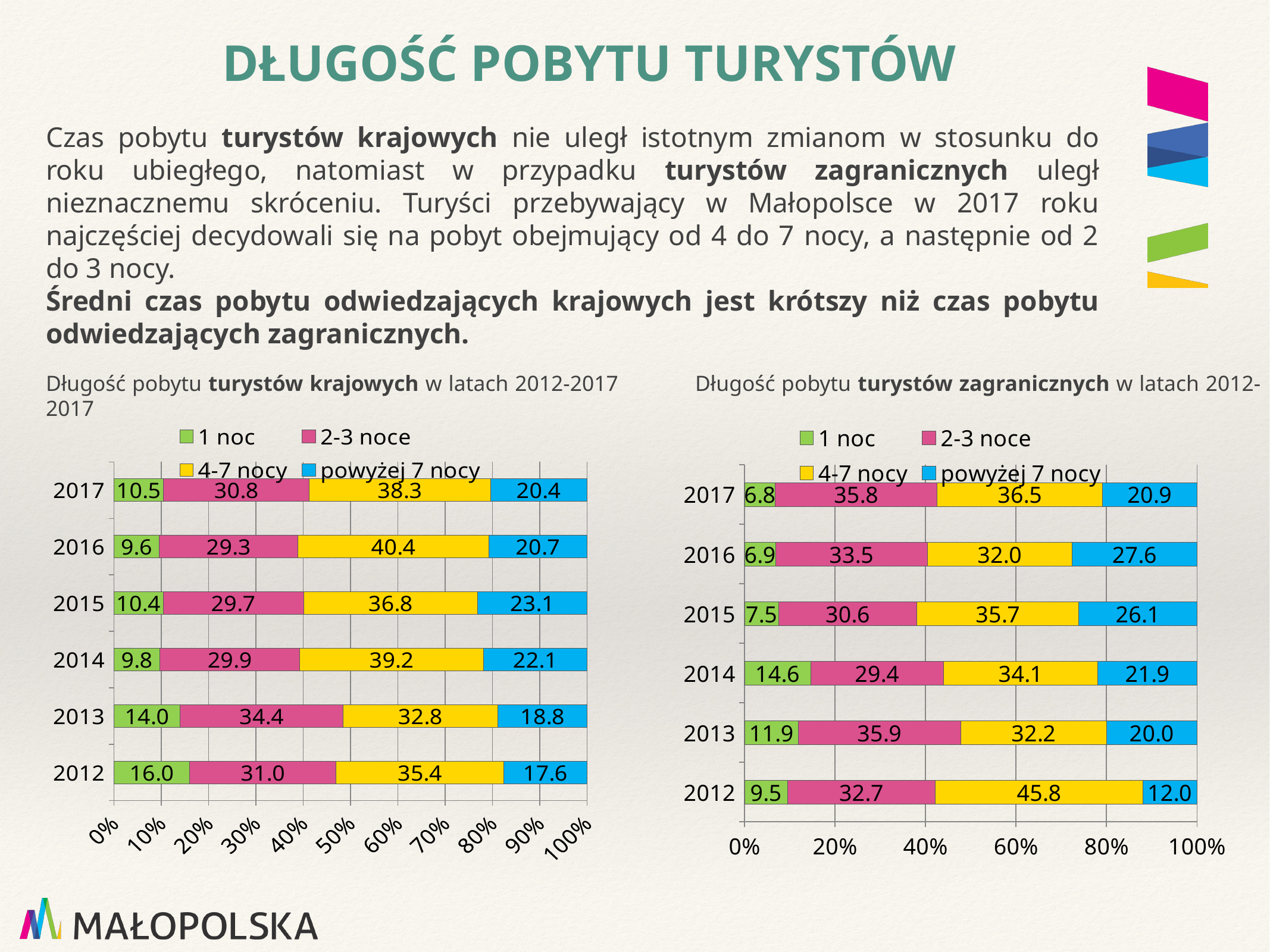
In the left chart (turystów krajowych), which is larger in 2013: the '2-3 noce' value or the '4-7 nocy' value? 2-3 noce In the right chart (turystów zagranicznych), what is the difference between the '4-7 nocy' values for 2012 and 2017? 9.3 In the right chart (turystów zagranicznych), what is the value for '1 noc' in 2014? 14.6 In the right chart (turystów zagranicznych), which year has the lowest value for 'powyżej 7 nocy'? 2012 In the left chart (turystów krajowych), which year has the highest value for '1 noc'? 2012 In the left chart (turystów krajowych), what is the value for '4-7 nocy' in 2017? 38.3 In the right chart (turystów zagranicznych), what is the value for 'powyżej 7 nocy' in 2016? 27.6 What kind of chart is the left chart (turystów krajowych)? Stacked bar chart In the left chart (turystów krajowych), what is the difference between the 'powyżej 7 nocy' values for 2015 and 2012? 5.5 How many series does the legend of the right chart (turystów zagranicznych) list? 4 How many years are shown in the left chart (turystów krajowych)? 6 In the right chart (turystów zagranicznych), which colour represents the '4-7 nocy' series? Yellow